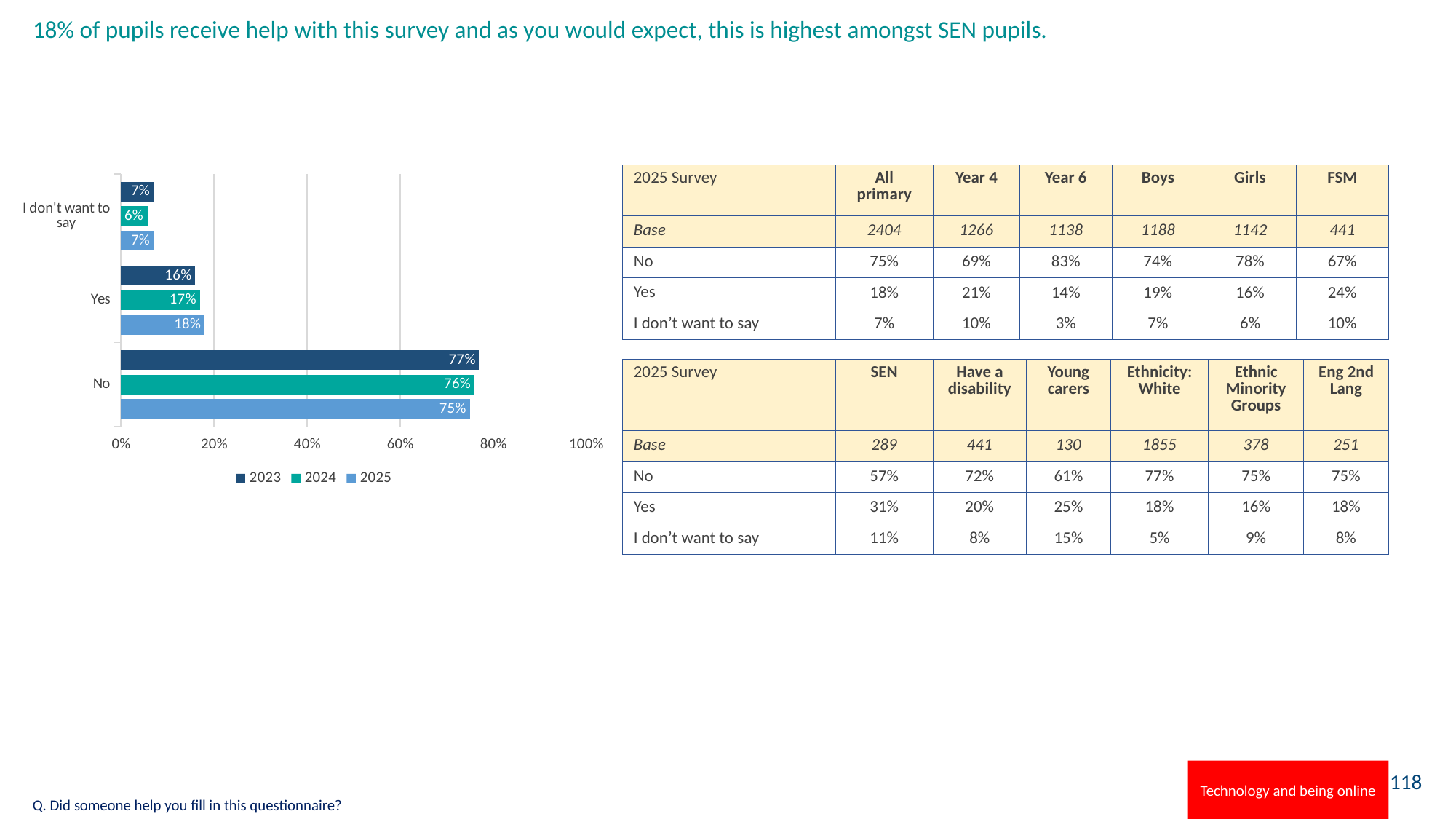
What is the value for 'Yes' in 2025? 18% Which response category has the highest value in 2025? No How many response categories are shown on the chart? 3 Is the value for 'No' in 2024 greater or less than 60%? greater What is the value for 'I don't want to say' in 2024? 6% Which years are listed in the chart legend? 2023, 2024, 2025 Which is larger: the 'Yes' value in 2023 or the 'Yes' value in 2025? 2025 What kind of chart is shown on the slide? bar chart What is the difference between the 'No' value in 2023 and the 'No' value in 2025? 2% Which response category has the lowest value in 2024? I don't want to say What is the value for 'No' in 2023? 77% How many series does the chart legend list? 3